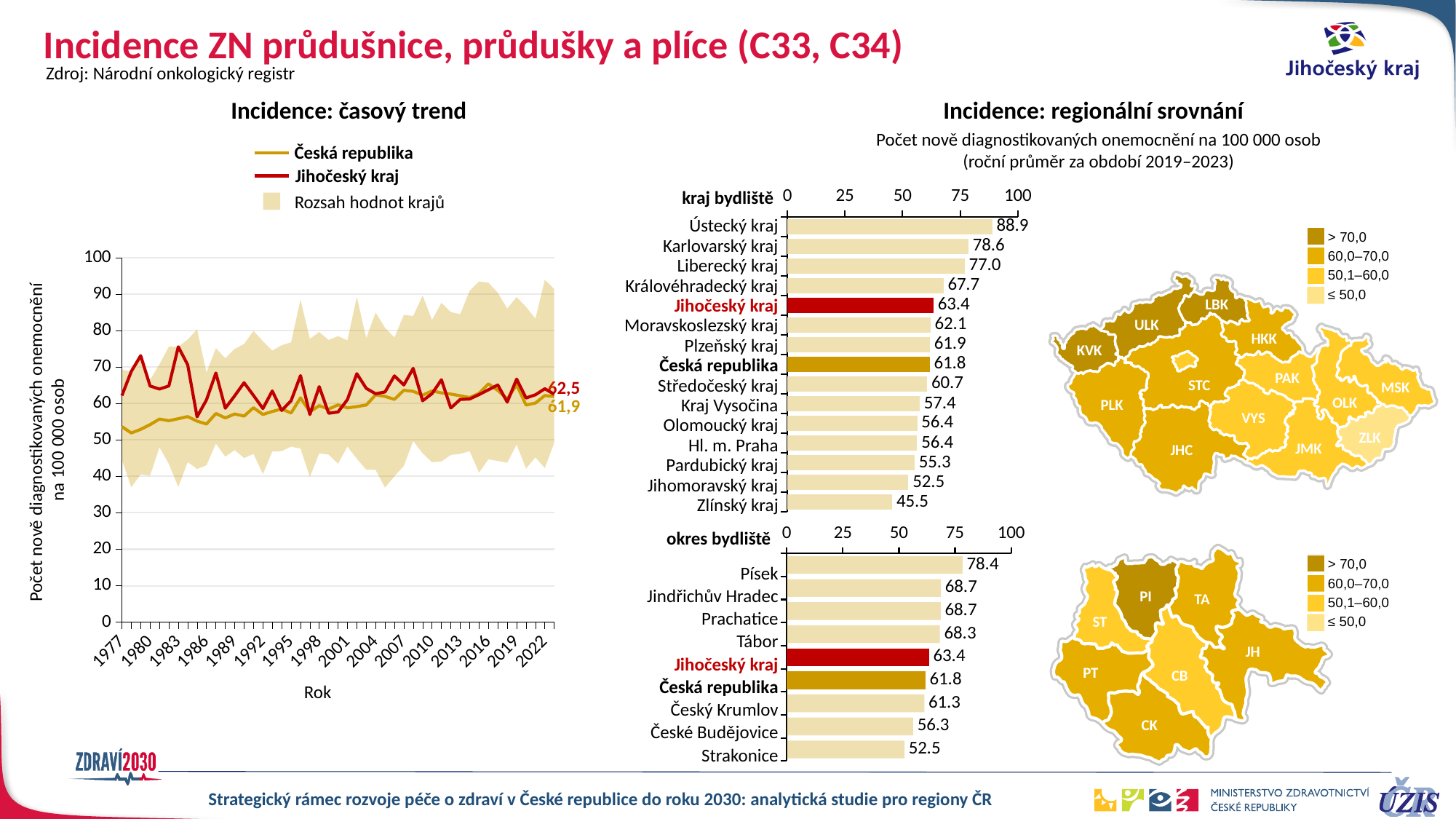
How many entries does the legend of the 'Incidence: časový trend' chart list? 3 In the 'Incidence: časový trend' chart, what is the last labelled value for Česká republika? 61,9 In the 'okres bydliště' bar chart, what is the difference between Písek and Tábor? 10.1 In the 'kraj bydliště' bar chart, which region has the lowest value? Zlínský kraj In the 'kraj bydliště' bar chart, what is the value for Ústecký kraj? 88.9 In the 'kraj bydliště' bar chart, what is the difference between Jihočeský kraj and Česká republika? 1.6 In the 'okres bydliště' bar chart, which district has the highest value? Písek In the 'kraj bydliště' bar chart, how many bars are shown? 15 In the 'kraj bydliště' bar chart, which is larger, Karlovarský kraj or Liberecký kraj? Karlovarský kraj In the 'okres bydliště' bar chart, what is the value for Strakonice? 52.5 In the 'Incidence: časový trend' chart, what is the last labelled value for Jihočeský kraj? 62,5 What kind of chart is the 'Incidence: časový trend' chart? line chart